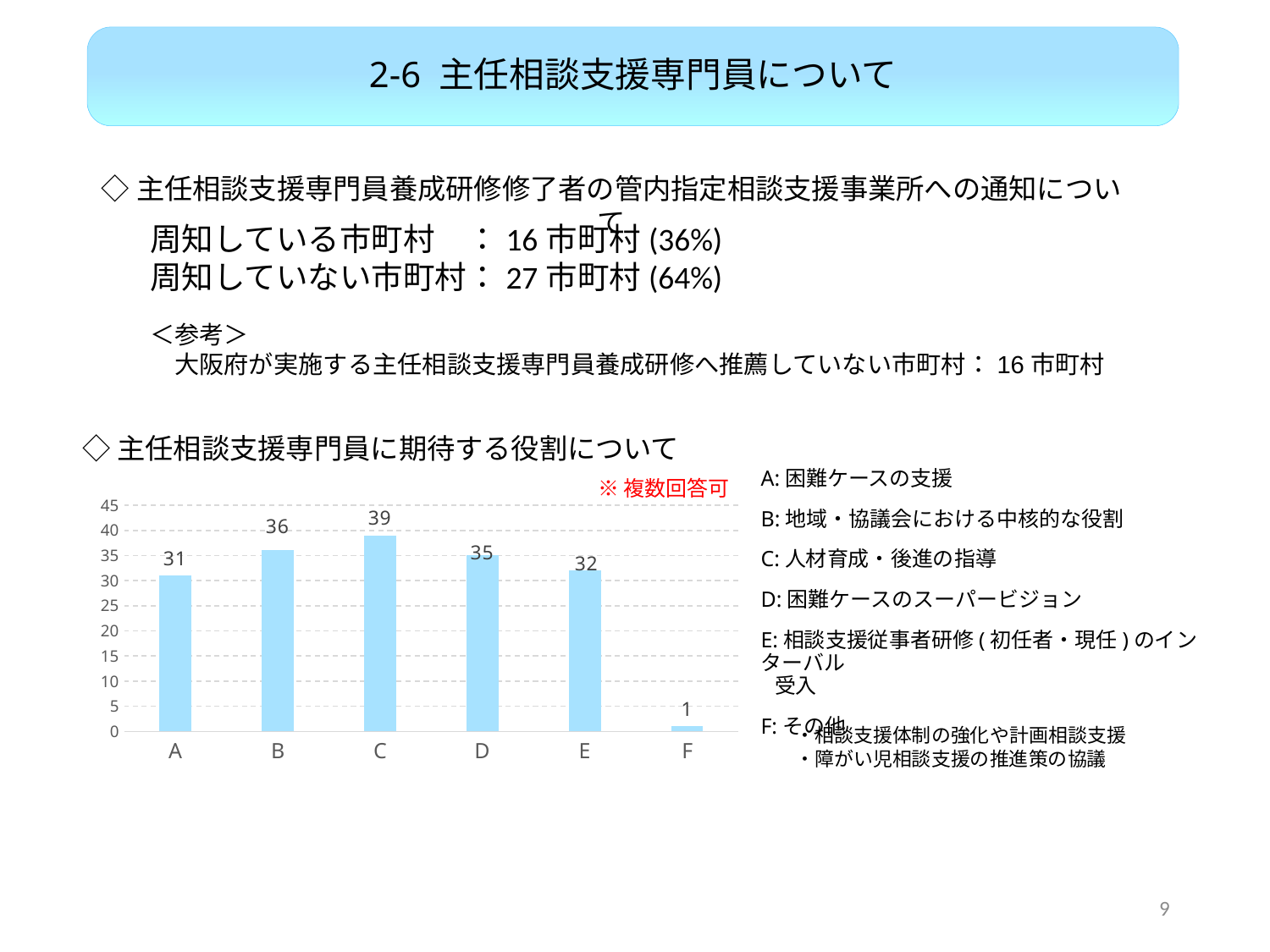
What is the value for category A? 31 What is the value for category C? 39 What kind of chart is shown on the slide? bar chart What is the maximum value shown on the y axis? 45 What is the difference between the values for C and A? 8 What is the difference between the values for B and E? 4 How many categories are shown on the x axis? 6 Which category has the lowest value? F Which is larger, the value for B or the value for D? B Which category has the highest value? C Is the value for E greater or less than 30? greater What is the value for category F? 1